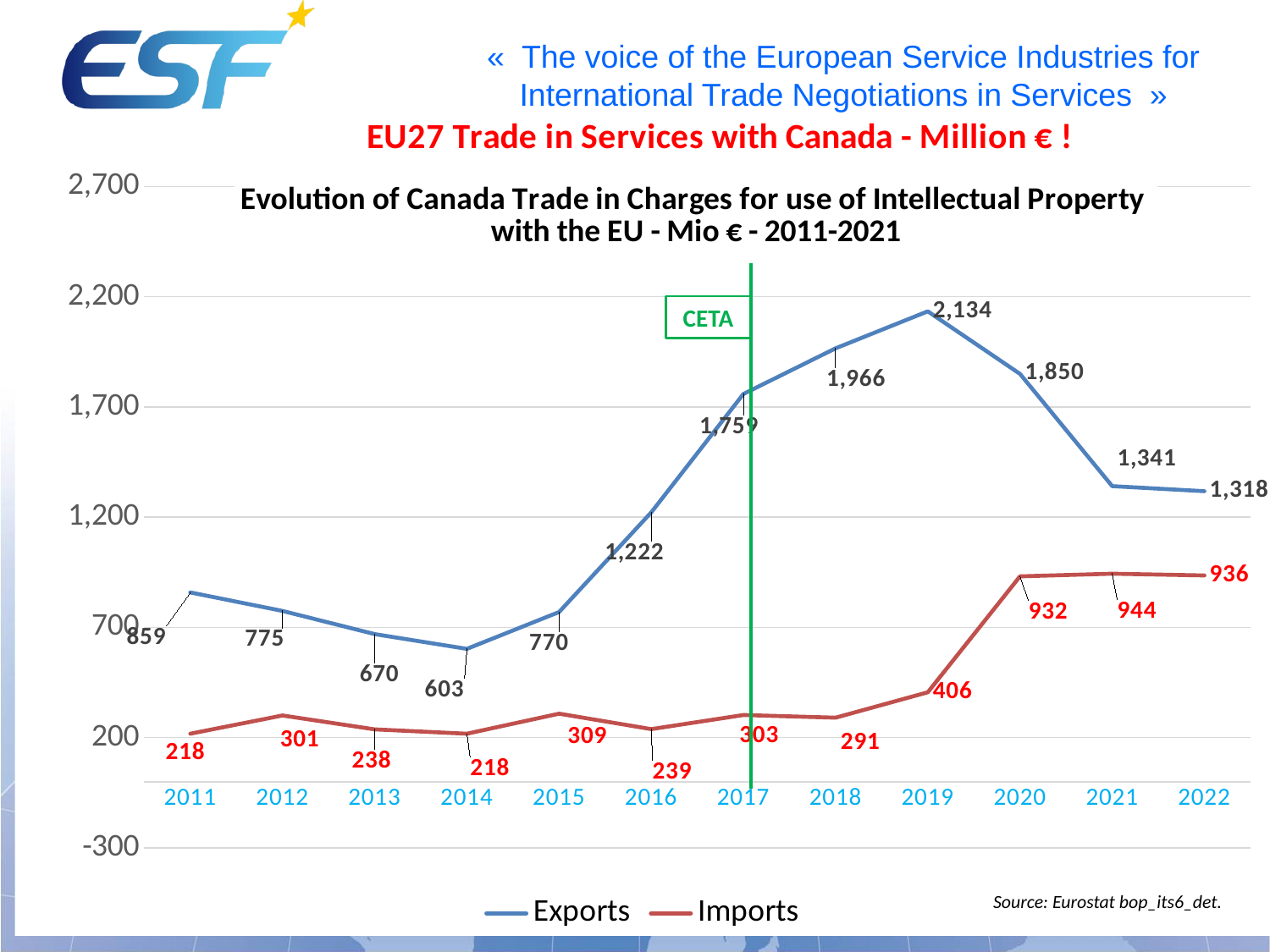
In which year are Exports lowest? 2014 What kind of chart is shown on the slide? Line chart How many years are shown on the x axis? 12 What is the value of Imports in 2020? 932 What is the value of Exports in 2019? 2,134 What is the value of Exports in 2014? 603 Do Exports rise or fall from 2019 to 2021? Fall In which year are Imports highest? 2021 How many series does the legend list? 2 In which year are Exports highest? 2019 Which is larger, Exports in 2017 or Exports in 2018? Exports in 2018 What is the difference between Exports and Imports in 2022? 382